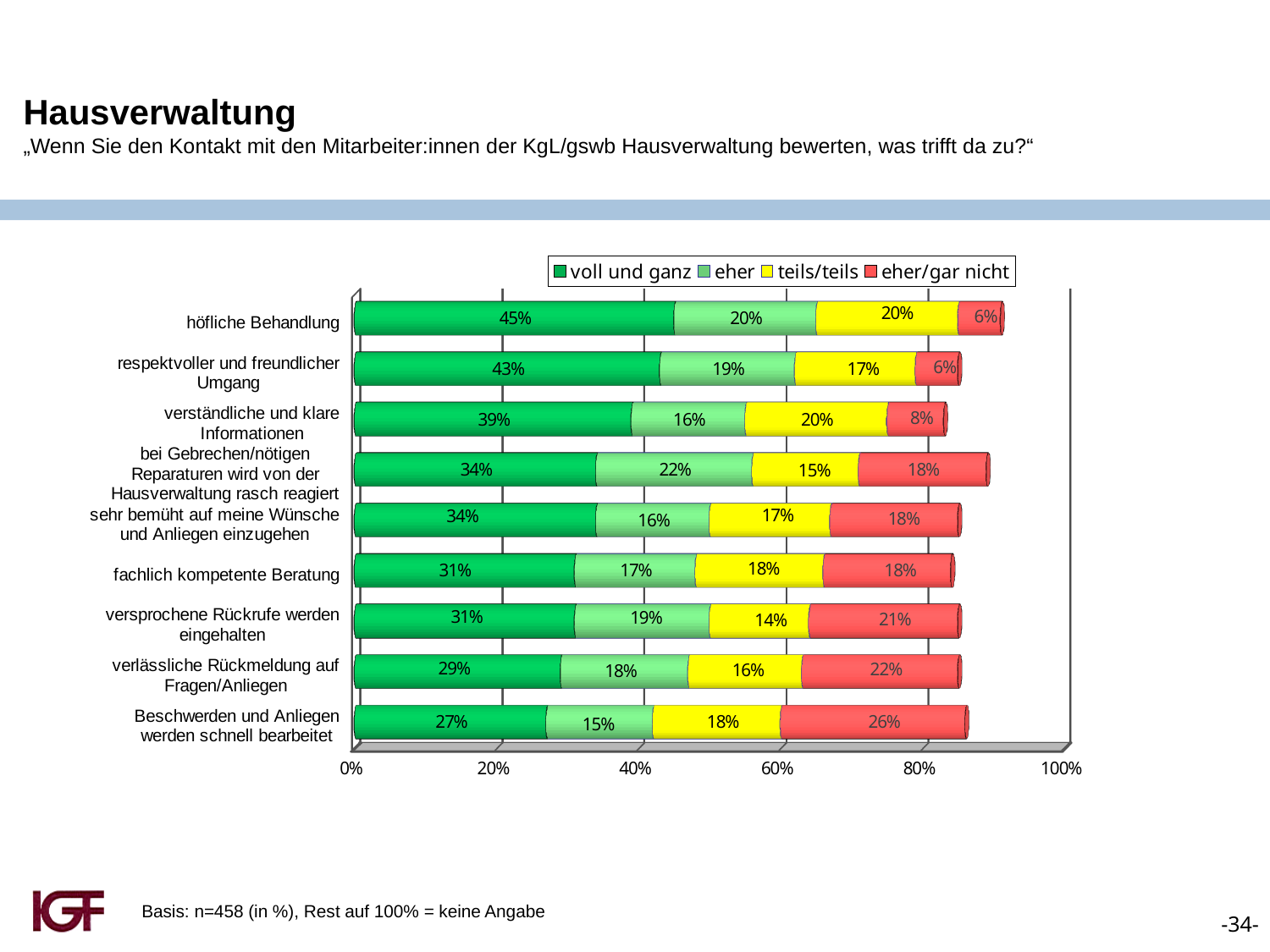
What is the 'teils/teils' value for 'versprochene Rückrufe werden eingehalten'? 14% How many series does the legend list? 4 What is the difference between the 'voll und ganz' values for 'höfliche Behandlung' and 'verständliche und klare Informationen'? 6% Which is larger: the 'eher/gar nicht' value for 'verlässliche Rückmeldung auf Fragen/Anliegen' or for 'fachlich kompetente Beratung'? verlässliche Rückmeldung auf Fragen/Anliegen Which legend entry is shown in red? eher/gar nicht Which category has the lowest 'voll und ganz' value? Beschwerden und Anliegen werden schnell bearbeitet What is the 'voll und ganz' value for 'höfliche Behandlung'? 45% How many categories (statements) are plotted in the chart? 9 What is the total of the stacked bar for 'höfliche Behandlung'? 91% What is the 'eher/gar nicht' value for 'Beschwerden und Anliegen werden schnell bearbeitet'? 26% What type of chart is shown on the slide? stacked bar chart Which category has the highest 'voll und ganz' value? höfliche Behandlung